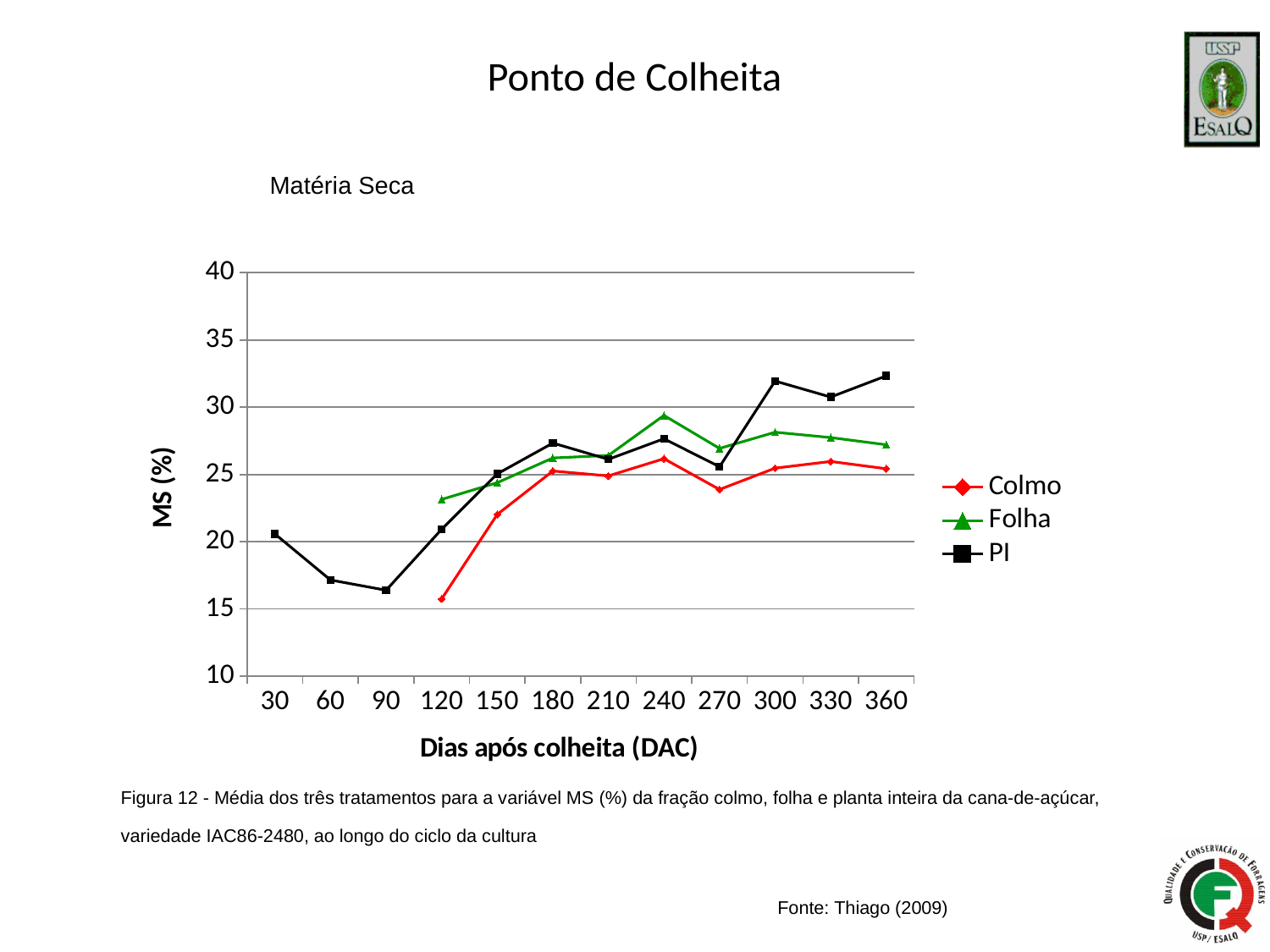
How many DAC points are shown on the x axis? 12 Is the value for PI at 360 DAC greater or less than 30? greater What is the title of the y axis? MS (%) At which DAC does the Folha series reach its highest value? 240 How many series does the legend list? 3 At which DAC is the Colmo series at its lowest value? 120 Which series has the highest MS (%) at 360 DAC? PI At 240 DAC, which is larger: Folha or Colmo? Folha Is the value for Colmo at 120 DAC greater or less than 20? less What kind of chart is shown on the slide? line chart Is the value for PI at 90 DAC greater or less than 20? less Does the PI series rise or fall from 30 DAC to 90 DAC? fall